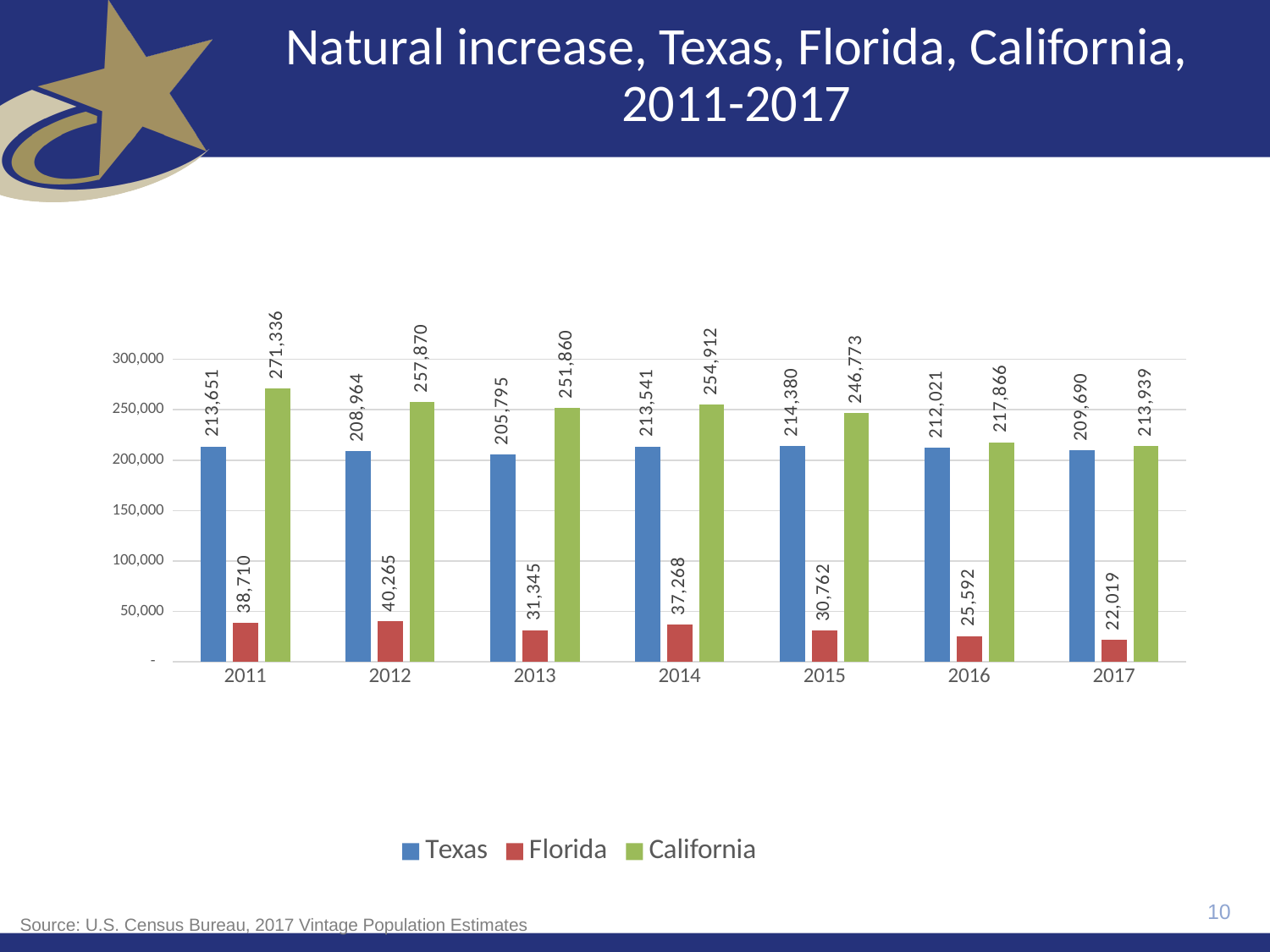
How many series does the legend list? 3 Does California's natural increase rise or fall from 2011 to 2017? Fall What is the natural increase for Texas in 2011? 213,651 Which is larger in 2012: Texas's natural increase or California's? California How many years are shown on the x axis? 7 What is the difference between California's and Texas's natural increase in 2017? 4,249 What kind of chart is shown on the slide? Bar chart What is the natural increase for California in 2014? 254,912 Is the value for Florida in 2012 greater or less than 50,000? less What is the natural increase for Florida in 2017? 22,019 In which year is California's natural increase highest? 2011 In which year is Florida's natural increase lowest? 2017